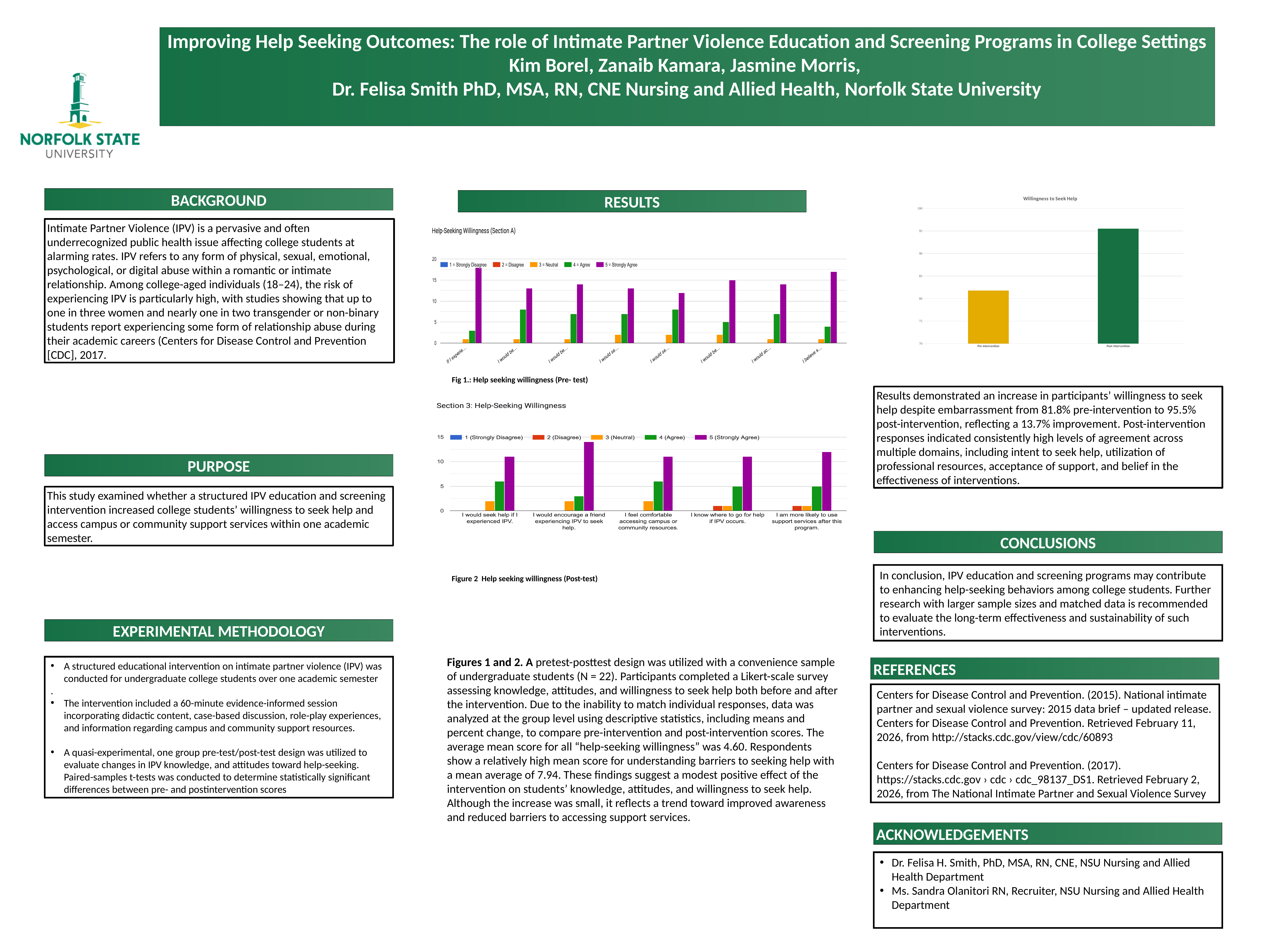
In the 'Willingness to Seek Help' chart, is the value for Pre Intervention greater or less than 85? less In the 'Help-Seeking Willingness (Section A)' chart (Fig 1), how many series does the legend list? 5 In the 'Section 3: Help-Seeking Willingness' chart (Figure 2), what colour are the '5 (Strongly Agree)' bars? purple In the 'Willingness to Seek Help' chart, how many categories are shown on the x axis? 2 In the 'Help-Seeking Willingness (Section A)' chart (Fig 1), which series has the tallest bar in every category? 5 = Strongly Agree In the 'Section 3: Help-Seeking Willingness' chart (Figure 2), how many categories are shown on the x axis? 5 In the 'Section 3: Help-Seeking Willingness' chart (Figure 2), is the '5 (Strongly Agree)' value for 'I would encourage a friend experiencing IPV to seek help.' greater or less than 10? greater In the 'Section 3: Help-Seeking Willingness' chart (Figure 2), which category has the highest '5 (Strongly Agree)' bar? I would encourage a friend experiencing IPV to seek help. In the 'Willingness to Seek Help' chart, which bar is taller, Pre Intervention or Post Intervention? Post Intervention In the 'Willingness to Seek Help' chart, is the value for Post Intervention greater or less than 90? greater What kind of chart is the 'Willingness to Seek Help' chart at the top right of the slide? bar chart In the 'Help-Seeking Willingness (Section A)' chart (Fig 1), how many categories are plotted along the x axis? 8